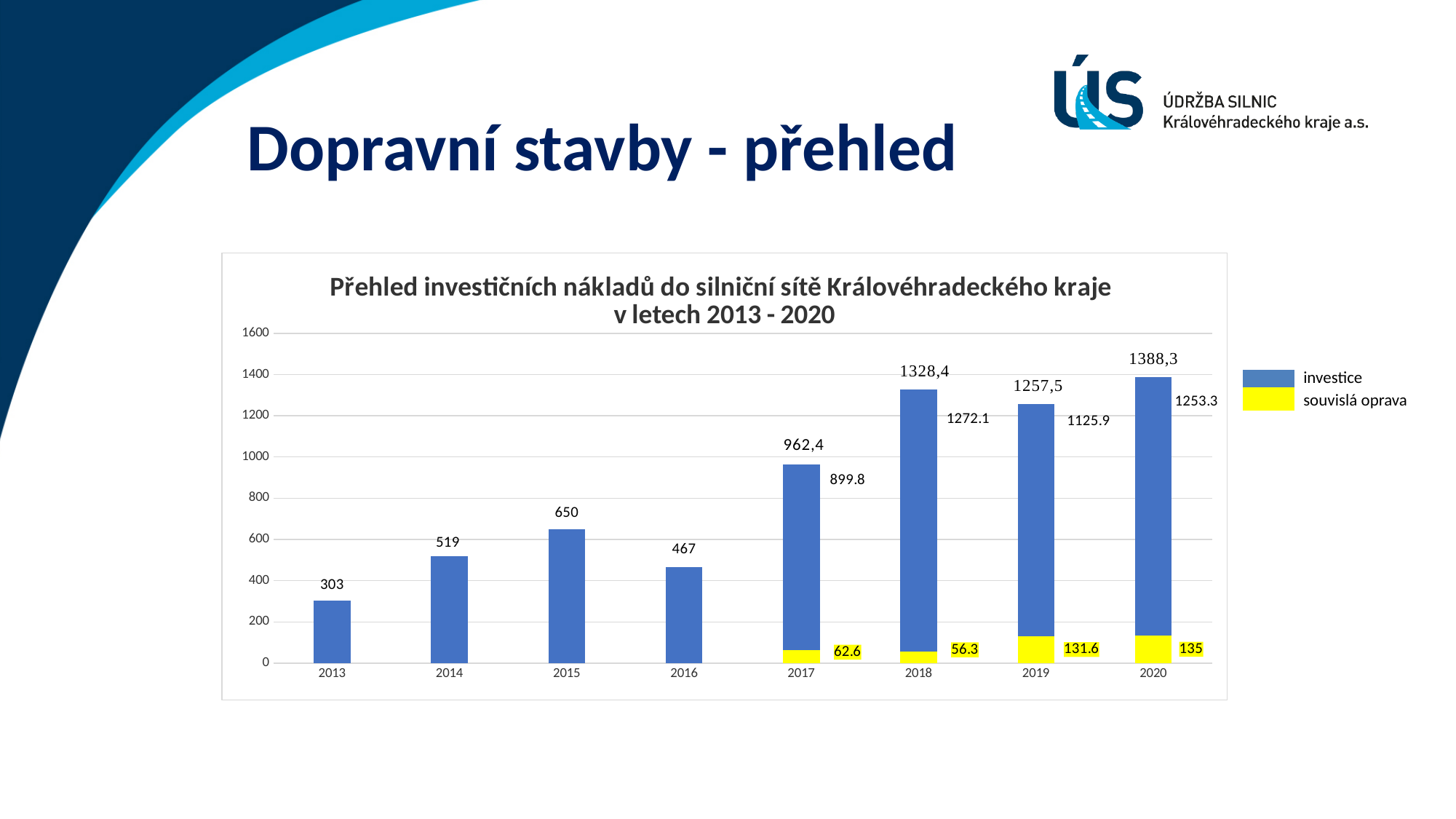
Which year has the lowest total bar? 2013 What is the value of souvislá oprava for 2019? 131.6 Which year has the highest total bar? 2020 How many series does the legend list? 2 What is the investice value labelled for 2017? 899.8 What is the value of souvislá oprava for 2020? 135 How many years are shown on the x axis of the chart? 8 What kind of chart is shown on the slide? bar chart What total is printed above the bar for 2020? 1388,3 What is the difference between the souvislá oprava values for 2020 and 2019? 3.4 Which year has the larger souvislá oprava value, 2017 or 2018? 2017 What is the investice value labelled for 2018? 1272.1